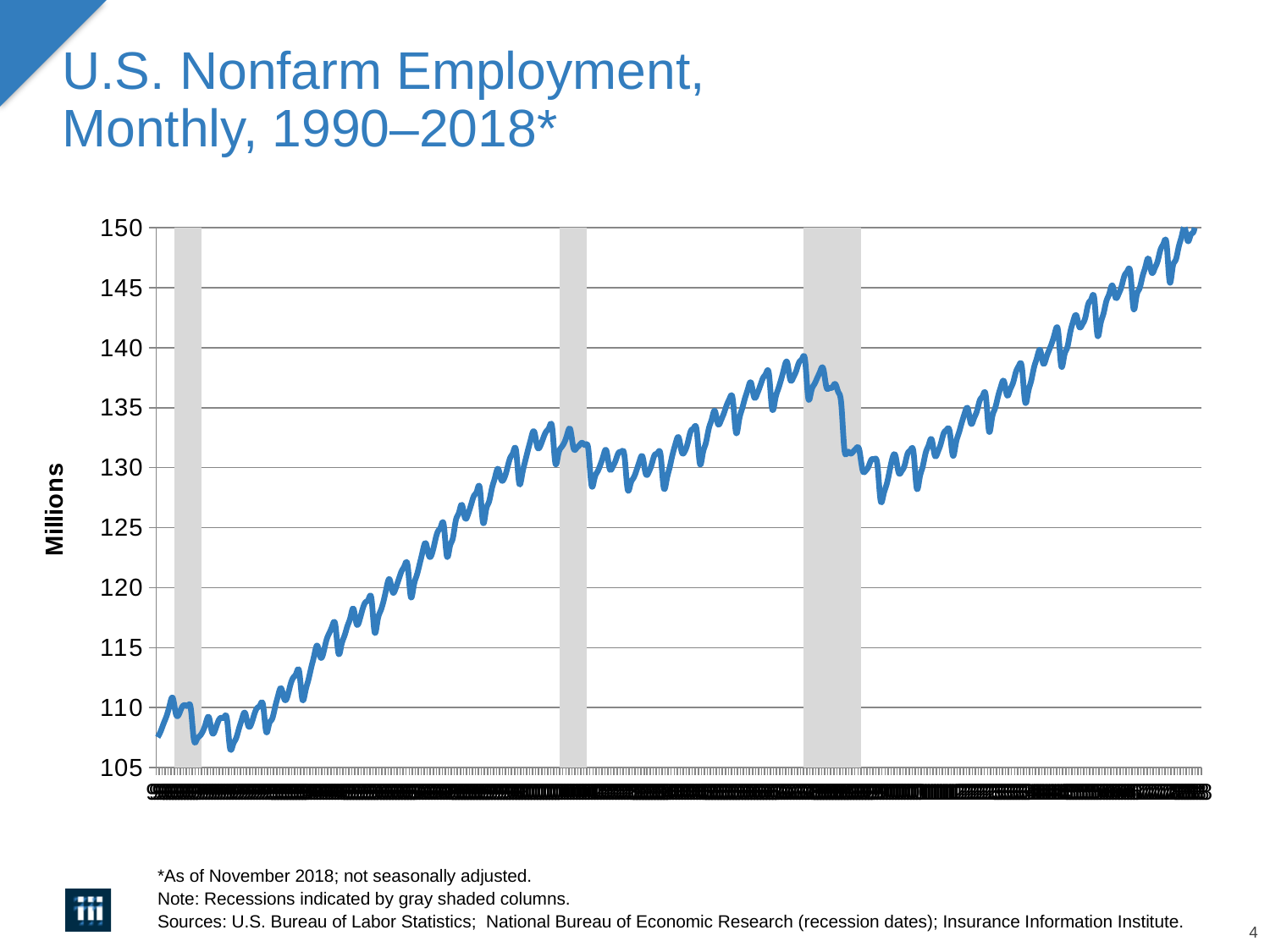
Is the lowest value reached just after the third gray shaded column greater or less than 125? greater Is the value at the start of the line greater or less than 105? greater Is the peak value reached just before the third gray shaded column greater or less than 140? less What is the label on the vertical axis of the chart? Millions What is the title of the chart? U.S. Nonfarm Employment, Monthly, 1990–2018* What kind of chart is shown on the slide? line chart Is the value at the end of the line larger or smaller than the value at the start of the line? larger What is the highest value shown on the vertical axis? 150 Overall, do the values rise or fall from the left of the chart to the right? rise